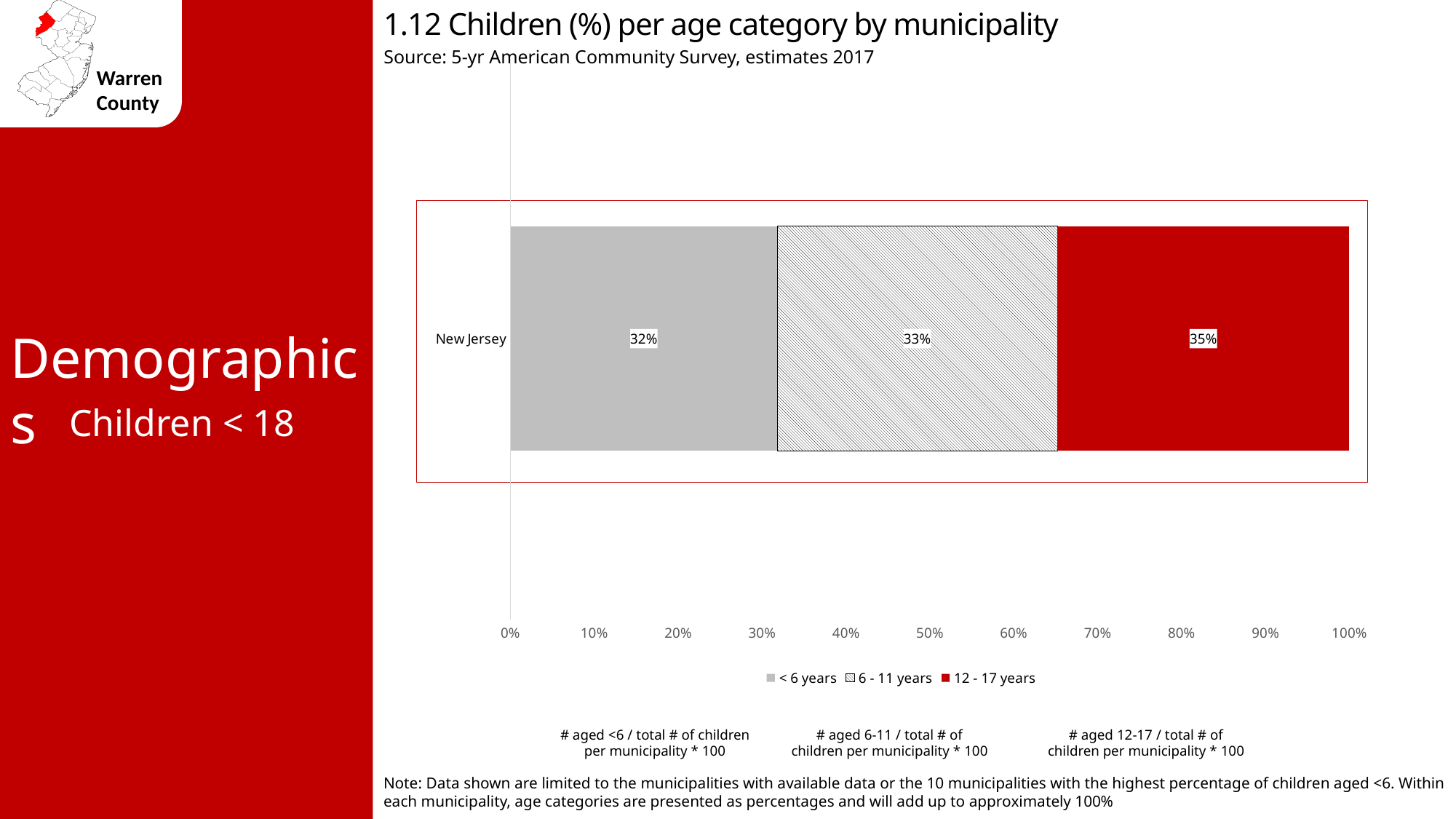
How many municipalities/categories are plotted on the chart? 1 What percentage of children in New Jersey are aged under 6 years? 32% What kind of chart is shown on the slide? Stacked bar chart Which is larger for New Jersey: the share of children aged 6 - 11 years or the share aged 12 - 17 years? 12 - 17 years Which age category has the lowest share of children in New Jersey? < 6 years What is the title of the chart? 1.12 Children (%) per age category by municipality What is the difference between the 12 - 17 years share and the < 6 years share for New Jersey? 3% What percentage of children in New Jersey are aged 12 - 17 years? 35% What percentage of children in New Jersey are aged 6 - 11 years? 33% How many series does the legend list? 3 Which age category has the highest share of children in New Jersey? 12 - 17 years What is the total of the stacked bar for New Jersey? 100%